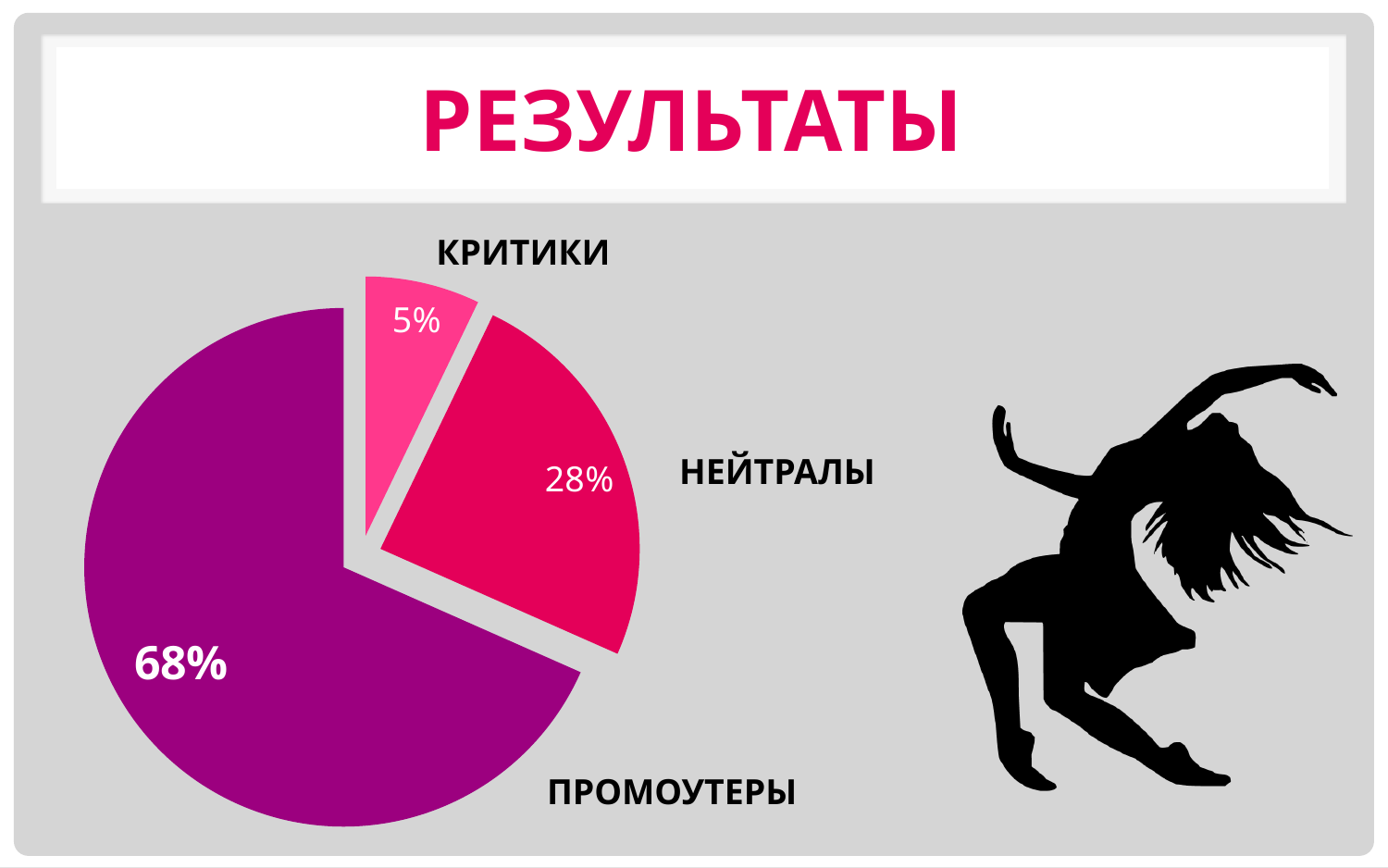
What is the difference in percentage points between ПРОМОУТЕРЫ and НЕЙТРАЛЫ? 40 What percentage is shown for ПРОМОУТЕРЫ? 68% Which category has the smallest share of the pie? КРИТИКИ What colour is the ПРОМОУТЕРЫ slice? purple How many slices does the pie chart have? 3 What percentage is shown for НЕЙТРАЛЫ? 28% What kind of chart is shown on the slide? pie chart What percentage is shown for КРИТИКИ? 5% Which is larger, the share for НЕЙТРАЛЫ or the share for КРИТИКИ? НЕЙТРАЛЫ What is the difference in percentage points between НЕЙТРАЛЫ and КРИТИКИ? 23 Which category has the largest share of the pie? ПРОМОУТЕРЫ What is the title of the slide containing the pie chart? РЕЗУЛЬТАТЫ